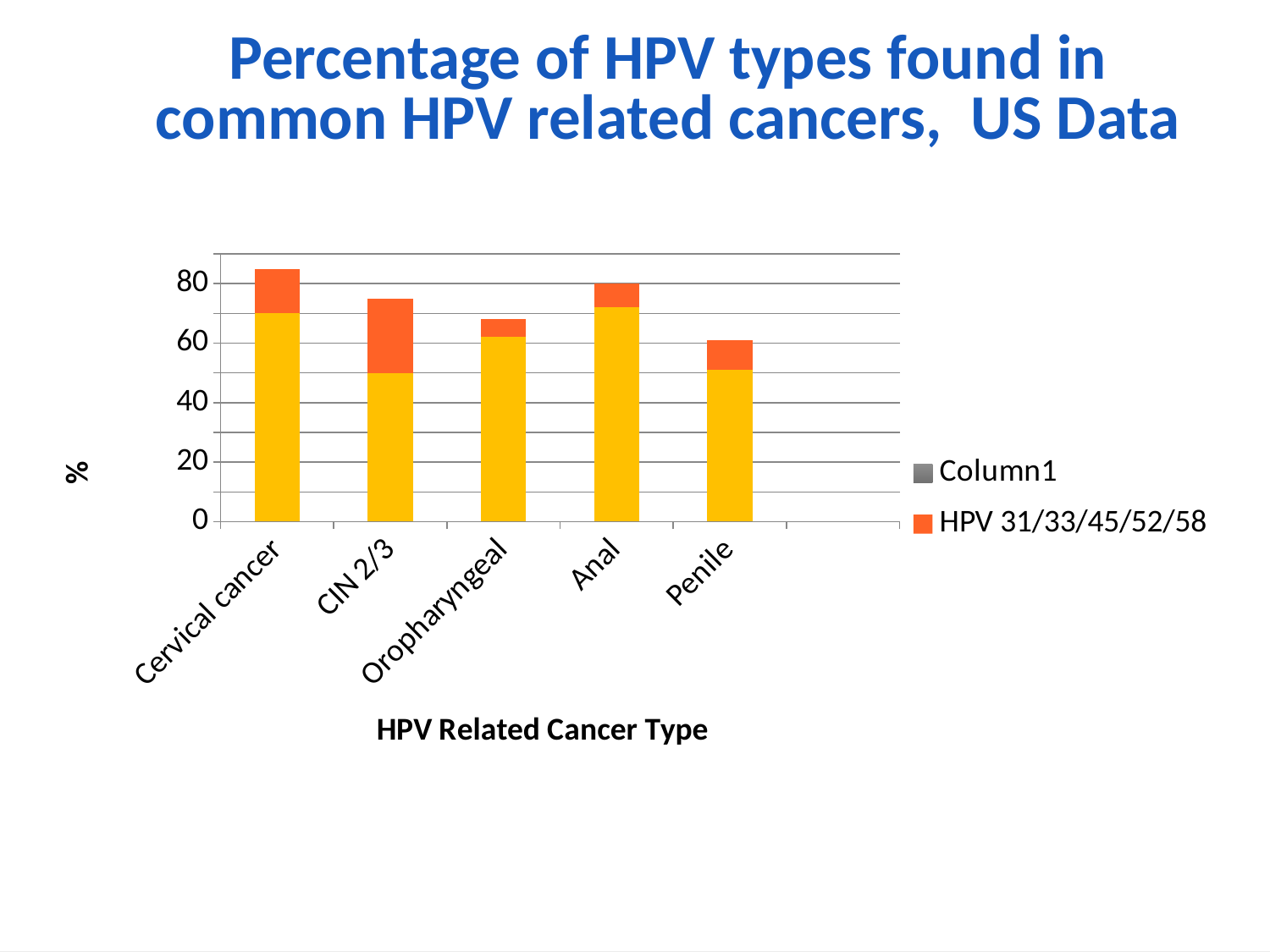
How many series does the chart's legend list? 2 Which cancer type has the largest orange (HPV 31/33/45/52/58) segment? CIN 2/3 Which cancer type has the shortest bar overall? Penile Is the total bar height for Penile greater or less than 80? less What kind of chart is shown on the slide? bar chart Is the total bar for Cervical cancer taller or shorter than the total bar for Penile? taller Is the total bar height for Cervical cancer greater or less than 80? greater How many cancer types are shown on the x axis of the chart? 5 Is the total bar height for Oropharyngeal greater or less than 60? greater What is the title of the x axis of the chart? HPV Related Cancer Type Which cancer type has the tallest bar overall? Cervical cancer